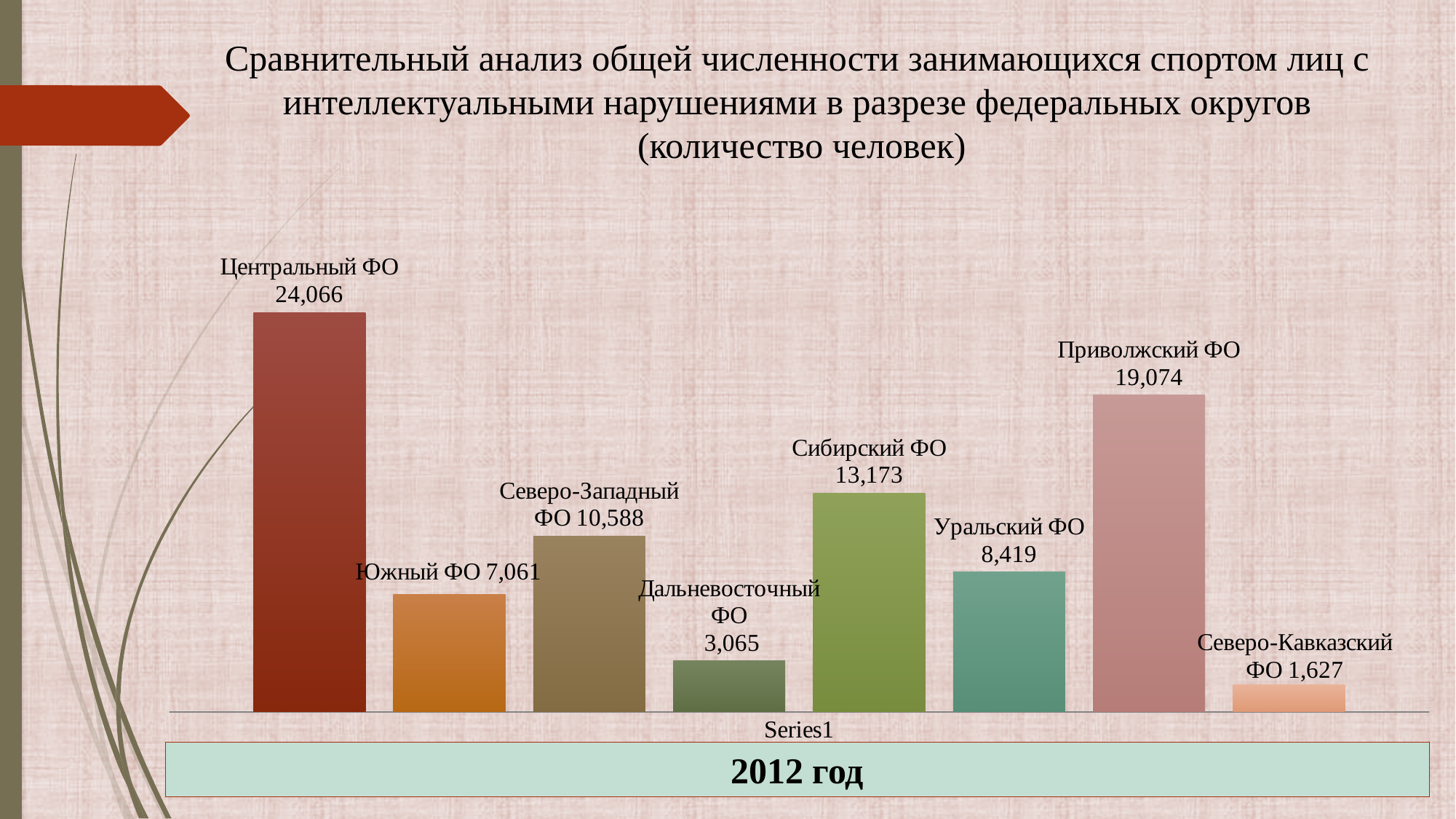
What is the value for Уральский ФО? 8,419 What is the value for Центральный ФО? 24,066 How many federal districts (bars) are shown in the chart? 8 What kind of chart is shown on the slide? Bar chart Which is larger, the value for Северо-Западный ФО or the value for Южный ФО? Северо-Западный ФО Which federal district has the lowest value? Северо-Кавказский ФО What year is indicated in the box below the chart? 2012 год What is the value for Приволжский ФО? 19,074 What is the difference between the values for Центральный ФО and Приволжский ФО? 4,992 What is the difference between the values for Сибирский ФО and Уральский ФО? 4,754 Which federal district has the highest value? Центральный ФО What is the value for Дальневосточный ФО? 3,065